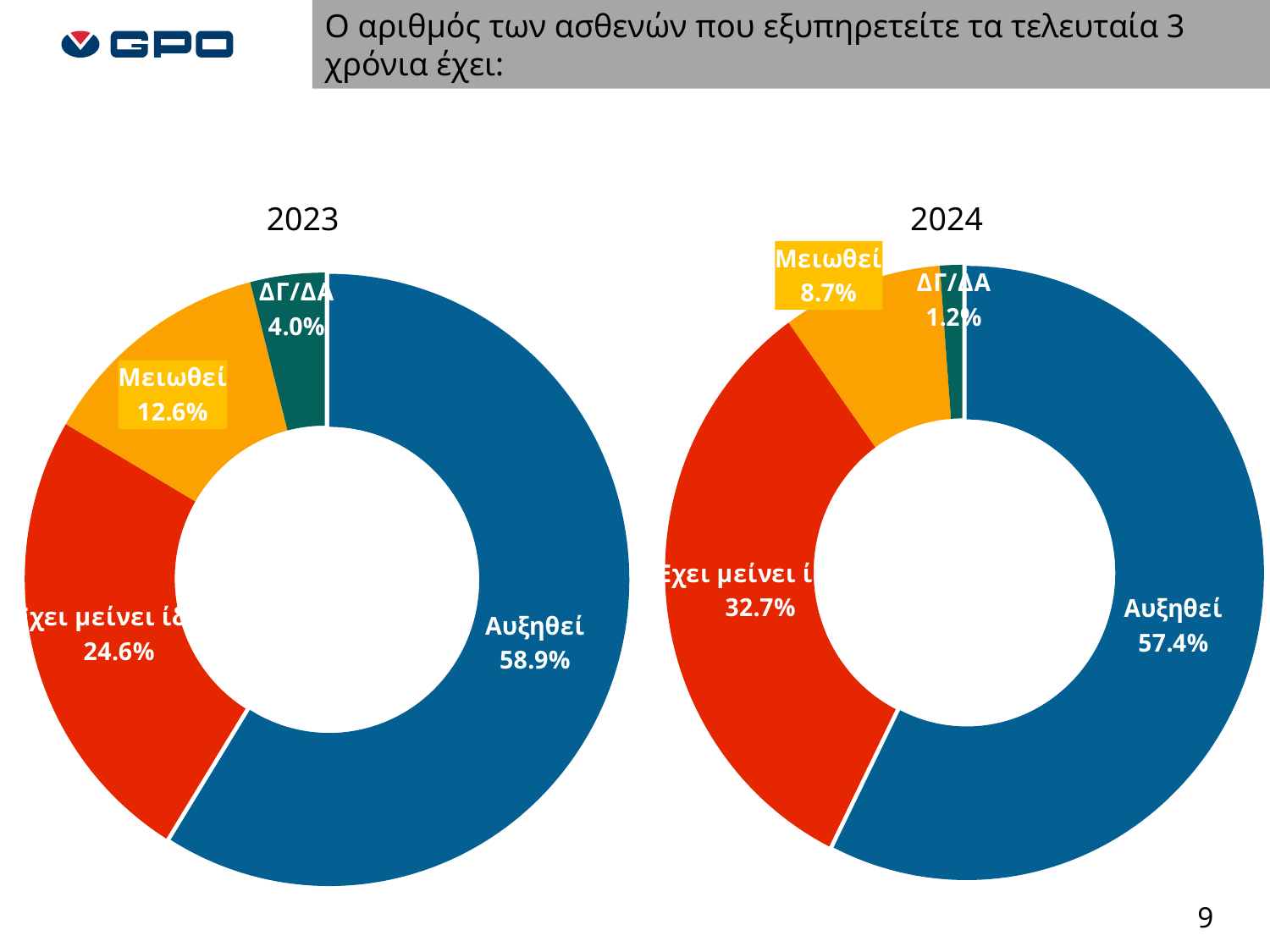
In the 2024 chart, what is the value of the red slice (Έχει μείνει...)? 32.7% In the 2024 chart, what is the value for Μειωθεί? 8.7% What is the difference between the Αυξηθεί values in the 2023 and 2024 charts? 1.5% In the 2024 chart, which category has the smallest share? ΔΓ/ΔΑ In the 2023 chart, which category has the largest share? Αυξηθεί What type of chart is used for 2023 and 2024? Donut (pie) chart In the 2023 chart, what is the difference between Μειωθεί and ΔΓ/ΔΑ? 8.6% Which is larger: Μειωθεί in the 2023 chart or Μειωθεί in the 2024 chart? 2023 In the 2023 chart, what is the value for Αυξηθεί? 58.9% In the 2024 chart, what is the value for ΔΓ/ΔΑ? 1.2% How many slices does the 2024 chart have? 4 In the 2023 chart, what is the value for ΔΓ/ΔΑ? 4.0%